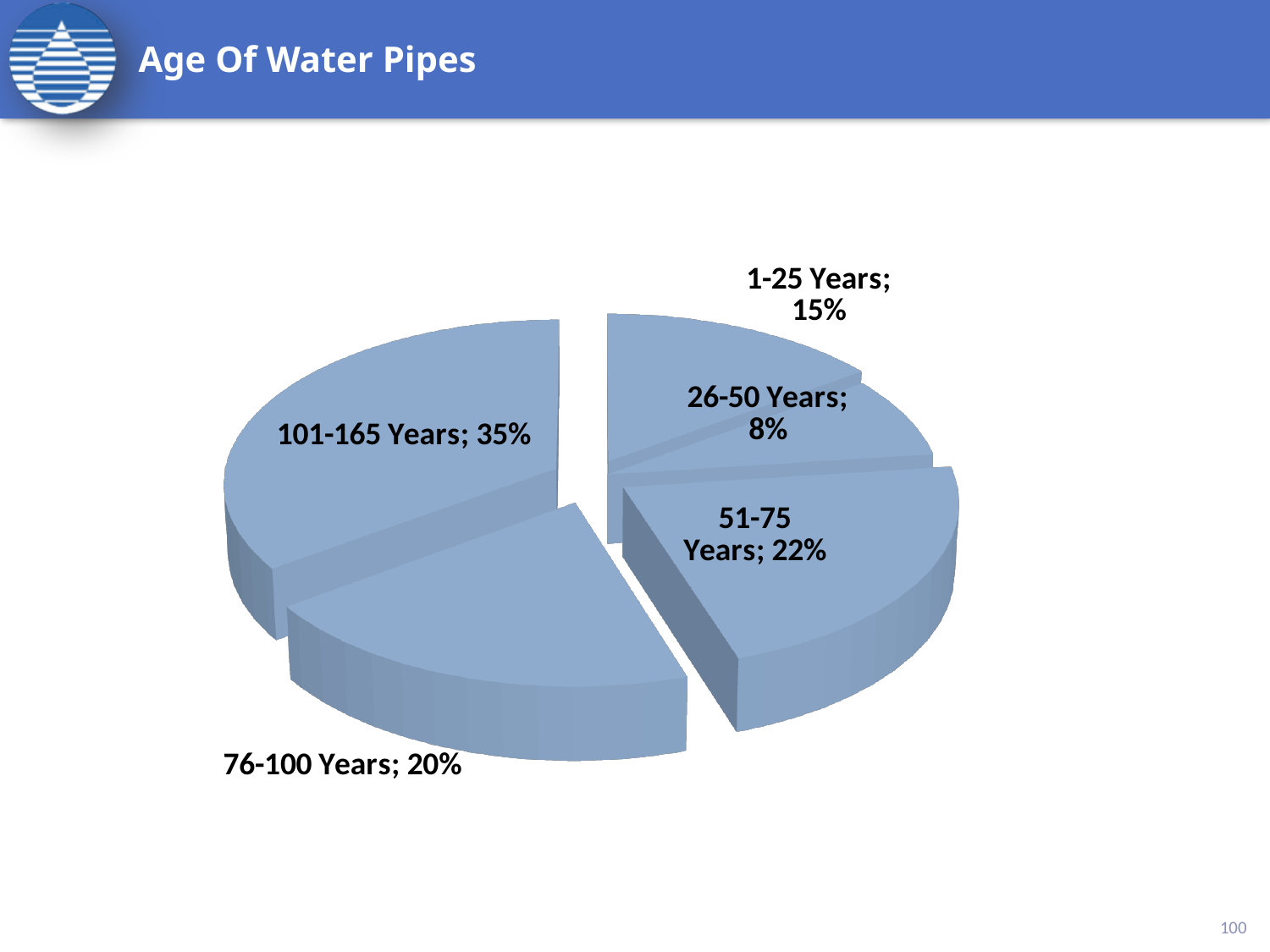
Which age group has the smallest share of water pipes? 26-50 Years Which is larger, the share for 51-75 Years or the share for 1-25 Years? 51-75 Years Which age group has the largest share of water pipes? 101-165 Years What share of water pipes are 1-25 years old? 15% What share of water pipes are 101-165 years old? 35% What kind of chart is shown on the slide? Pie chart What share of water pipes are 51-75 years old? 22% What share of water pipes are 26-50 years old? 8% What is the title of the slide containing the chart? Age Of Water Pipes What share of water pipes are 76-100 years old? 20% What is the difference in percentage points between the 101-165 Years slice and the 76-100 Years slice? 15 How many age categories are shown in the pie chart? 5